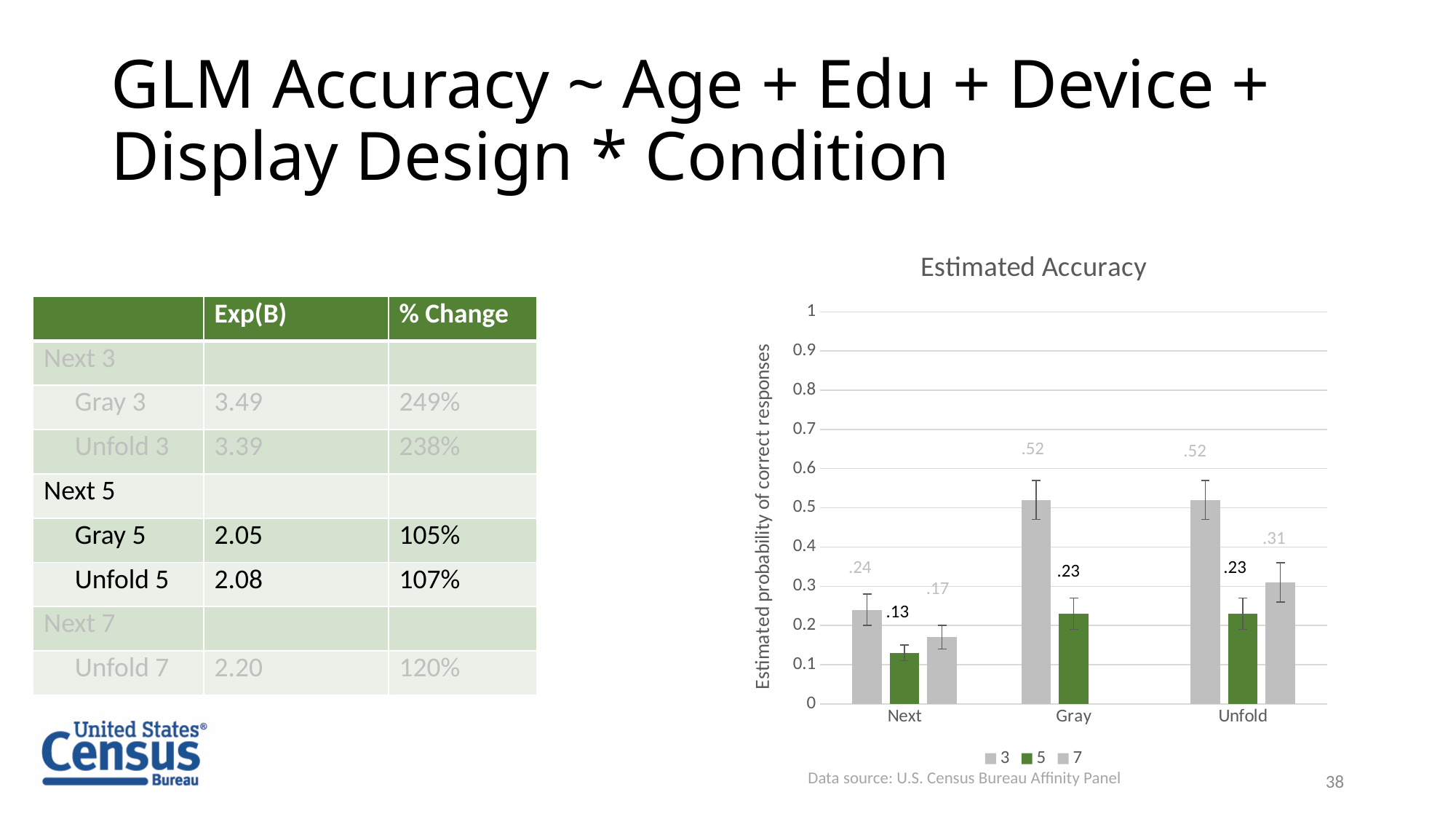
What is the label of the y axis of the chart? Estimated probability of correct responses What is the title of the chart? Estimated Accuracy What is the value for series 3 in the Gray category? .52 What is the difference between the series 3 value and the series 5 value in the Unfold category? .29 Which category has the lowest value for series 3? Next How many series does the chart legend list? 3 Which is larger in the Next category: the value for series 3 or the value for series 7? series 3 What type of chart is shown on the slide? bar chart What is the value for series 7 in the Unfold category? .31 What is the value for series 5 in the Next category? .13 How many categories are shown on the x axis of the chart? 3 Is the value for series 3 in the Unfold category greater or less than 0.4? greater